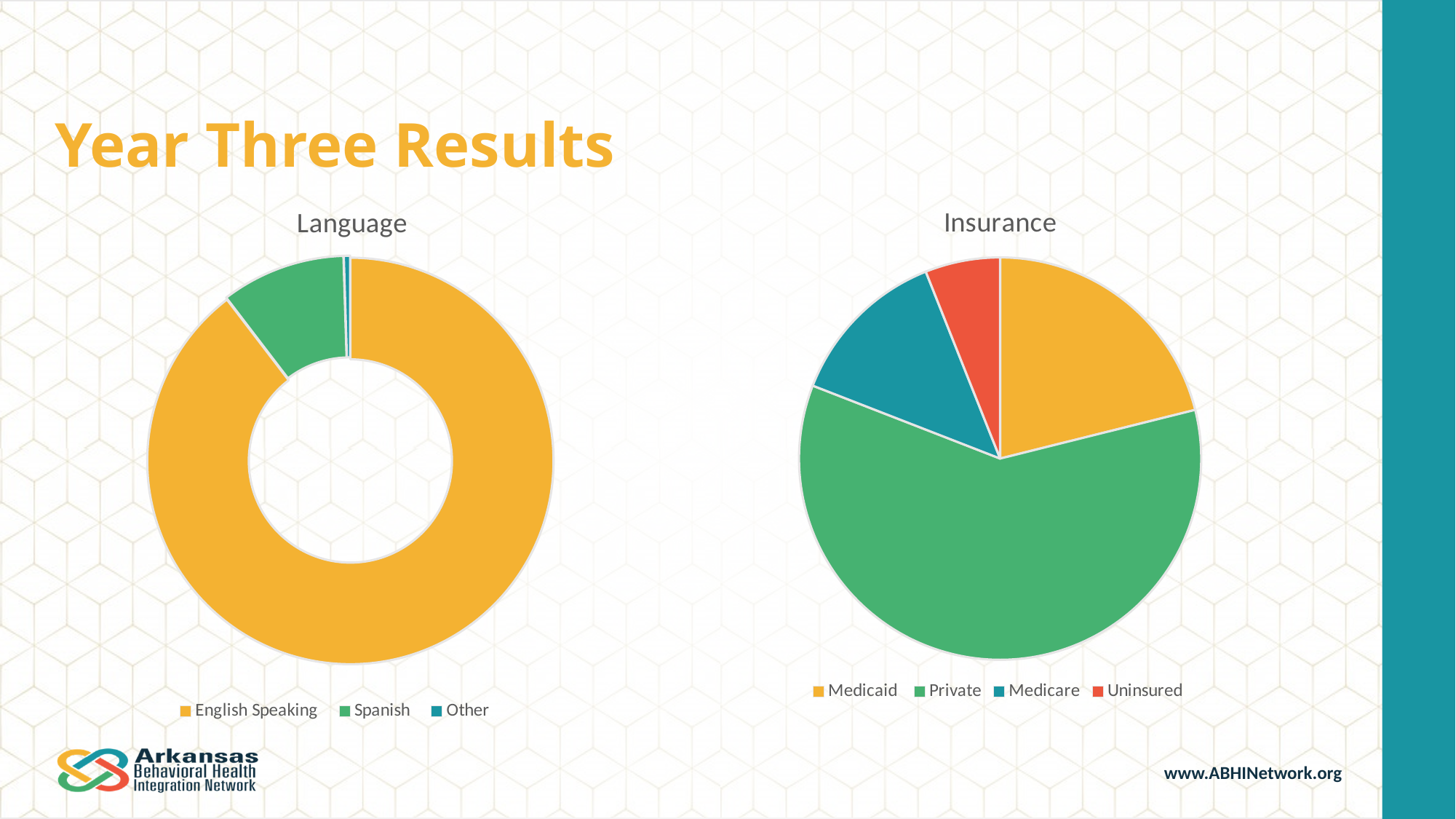
In the Language chart, which is larger, Spanish or Other? Spanish How many categories does the Language chart show? 3 In the Insurance chart, what colour is the Uninsured slice? Red In the Language chart, which category has the smallest share? Other In the Insurance chart, which is larger, Medicare or Uninsured? Medicare In the Language chart, which category has the largest share? English Speaking In the Insurance chart, which is larger, Medicaid or Medicare? Medicaid What kind of chart is the Language chart? Doughnut chart In the Insurance chart, which category has the smallest share? Uninsured What kind of chart is the Insurance chart? Pie chart How many categories does the Insurance chart show? 4 In the Insurance chart, which category has the largest share? Private